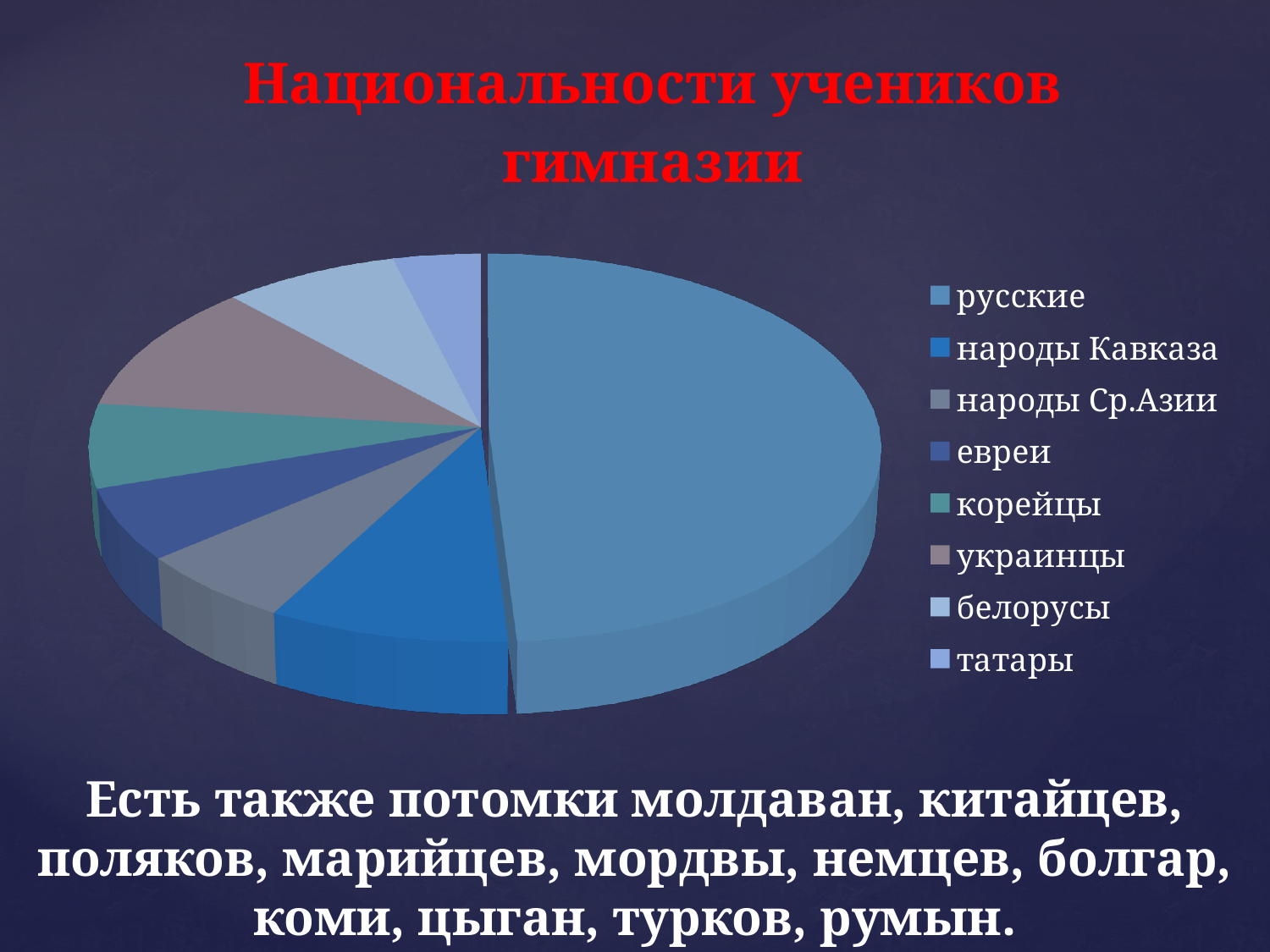
Which slice is larger: народы Кавказа or татары? народы Кавказа Which slice is larger: народы Кавказа or корейцы? народы Кавказа Which slice is larger: русские or народы Кавказа? русские How many categories does the legend of the pie chart list? 8 Which category is listed first in the legend? русские What is the title of the chart? Национальности учеников гимназии What kind of chart is shown on the slide? pie chart Which nationality has the largest slice of the pie chart? русские